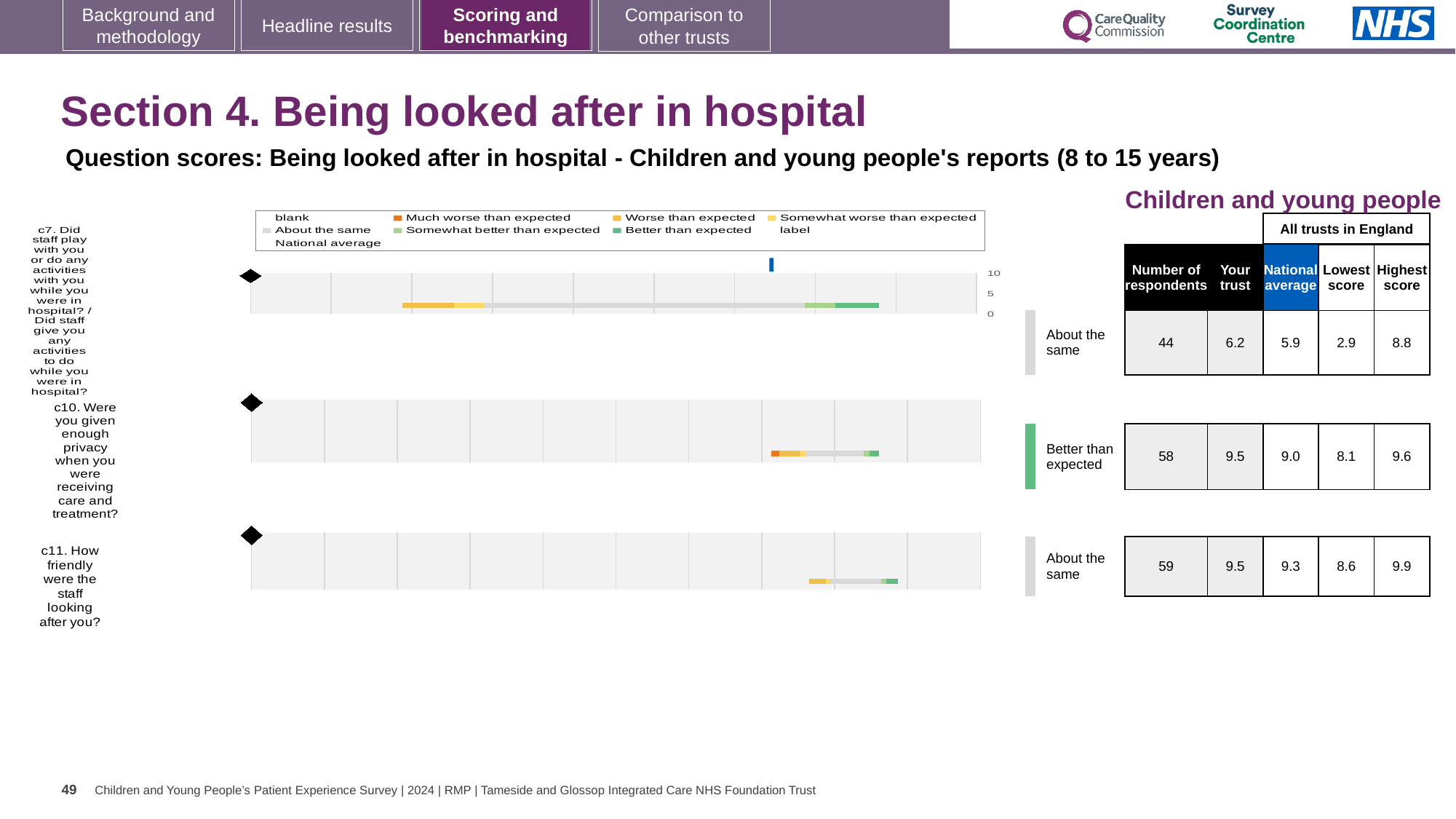
How many questions (bars) are plotted on the slide? 3 Which question has the lowest 'Your trust' score? c7 Which question is rated 'Better than expected' for this trust? c10 What is the difference between the highest and lowest scores across all trusts for question c11? 1.3 What is the national average score for question c10 (Were you given enough privacy when you were receiving care and treatment?)? 9.0 Which question has the most respondents? c11 For question c7, which is larger: the 'Your trust' score or the national average? Your trust What is the 'Your trust' score for question c7 (Did staff play with you or do any activities with you while you were in hospital?)? 6.2 Is the 'Your trust' score for question c7 greater or less than 5? greater What kind of chart is used to show the question scores on this slide? bar chart What is the lowest score across all trusts in England for question c7? 2.9 How many respondents answered question c11 (How friendly were the staff looking after you?)? 59